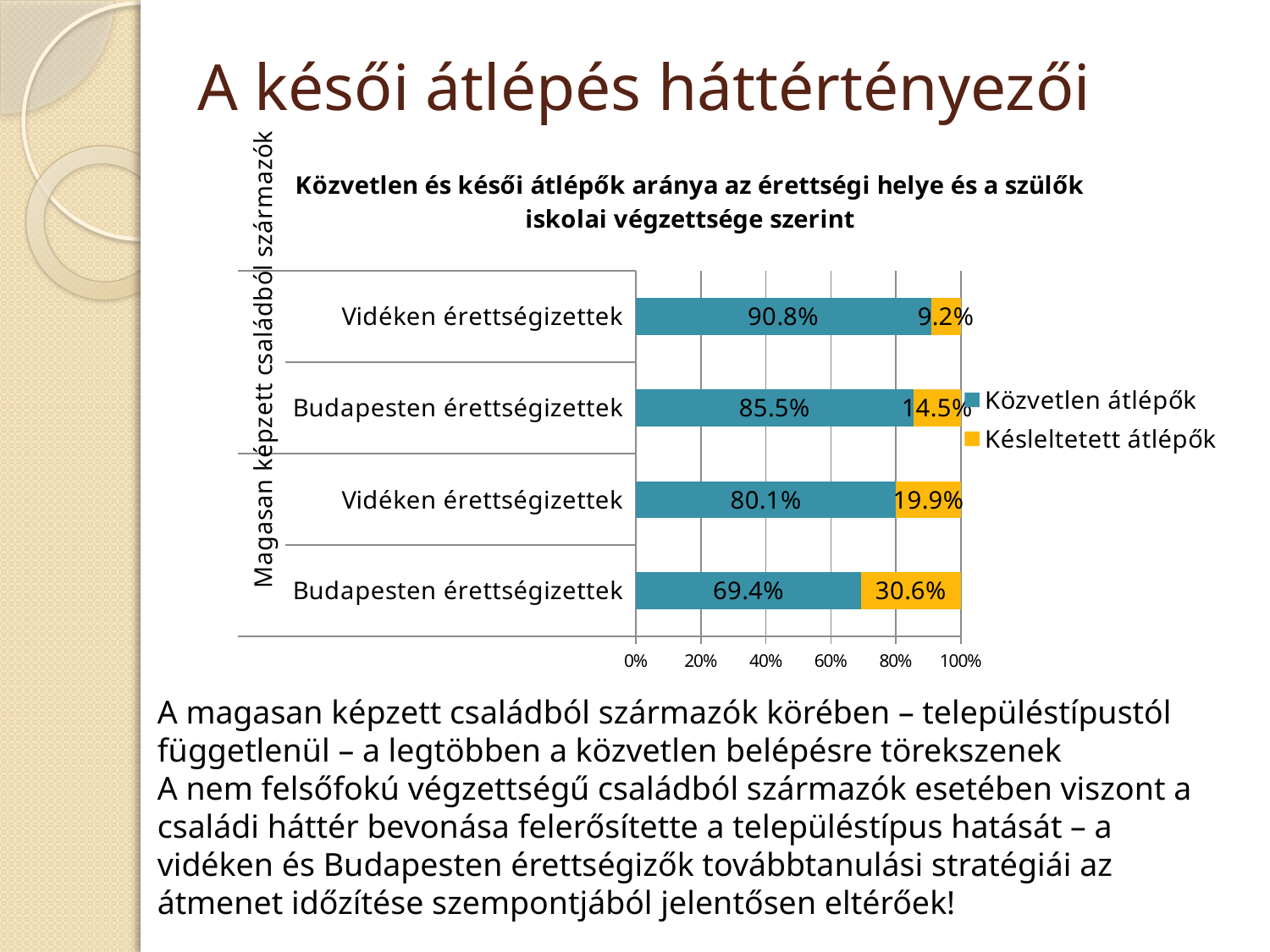
What is the Késleltetett átlépők value for the second bar from the top (Budapesten érettségizettek, magasan képzett családból származók)? 14.5% What is the difference between the Közvetlen átlépők values of the top bar (90.8%) and the bottom bar (69.4%)? 21.4% How many bars (categories) are plotted in the chart? 4 Which is larger: the Késleltetett átlépők value of the third bar from the top (Vidéken érettségizettek) or of the second bar from the top (Budapesten érettségizettek)? Vidéken érettségizettek (third bar), 19.9% What is the title of the chart? Közvetlen és késői átlépők aránya az érettségi helye és a szülők iskolai végzettsége szerint What is the Közvetlen átlépők value for the top bar (Vidéken érettségizettek, magasan képzett családból származók)? 90.8% Which bar has the highest Késleltetett átlépők share? Budapesten érettségizettek (bottom bar) What is the Közvetlen átlépők value for the third bar from the top (Vidéken érettségizettek)? 80.1% What is the Késleltetett átlépők value for the bottom bar (Budapesten érettségizettek)? 30.6% Which bar has the lowest Késleltetett átlépők share? Vidéken érettségizettek (top bar) How many series does the legend list? 2 What type of chart is shown on the slide? stacked bar chart